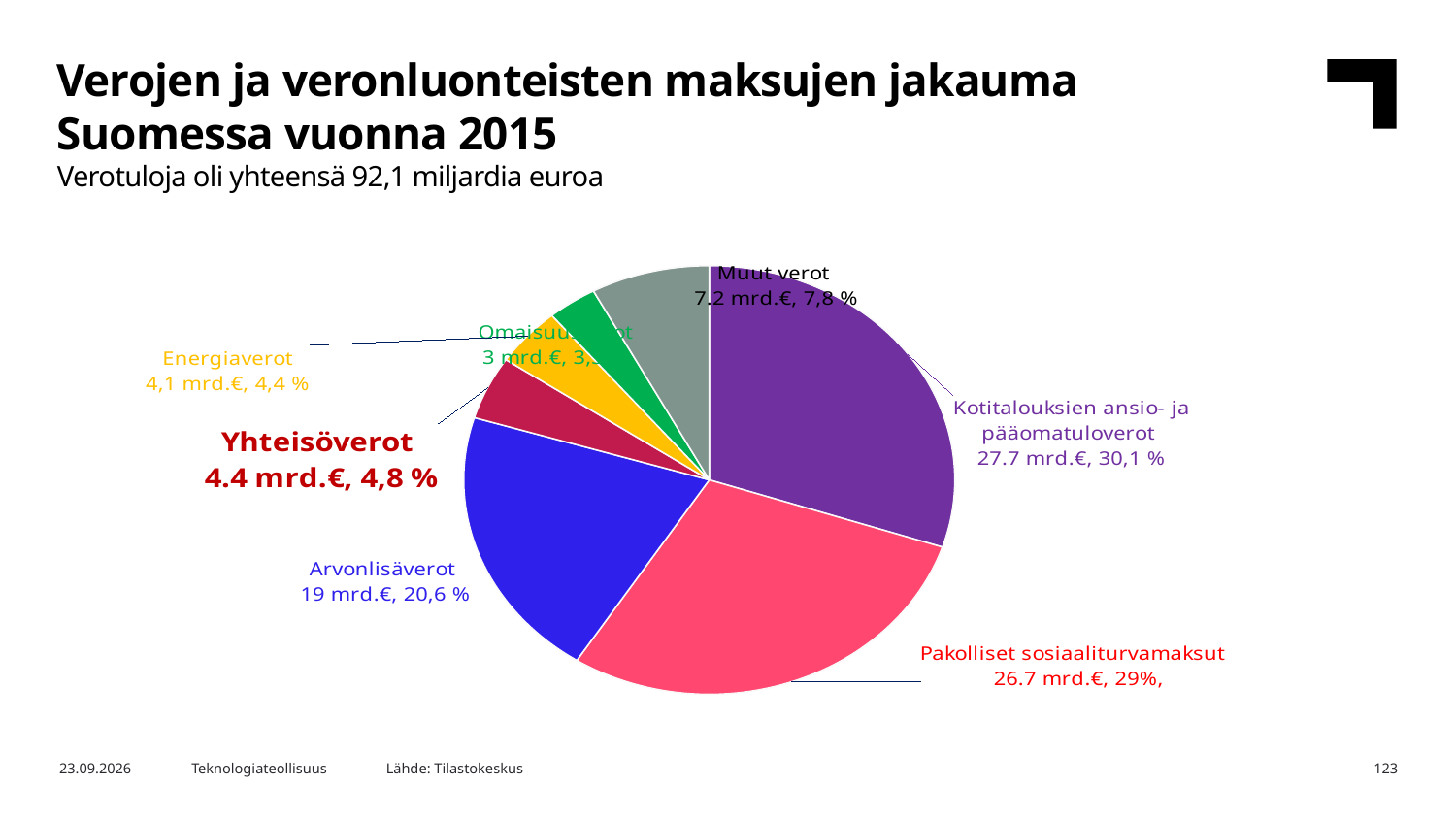
What percentage share is shown for Kotitalouksien ansio- ja pääomatuloverot? 30,1 % How many slices does the pie chart have? 7 Which category has the largest slice of the pie? Kotitalouksien ansio- ja pääomatuloverot Which is larger, Arvonlisäverot or Muut verot? Arvonlisäverot What kind of chart is shown on the slide? pie chart What is the value shown for Yhteisöverot? 4.4 mrd.€ According to the slide subtitle, what was the total tax revenue? 92,1 miljardia euroa What percentage share is shown for Energiaverot? 4,4 % What percentage share is shown for Muut verot? 7,8 % What is the value shown for Arvonlisäverot? 19 mrd.€ What is the difference in mrd.€ between Kotitalouksien ansio- ja pääomatuloverot and Pakolliset sosiaaliturvamaksut? 1 mrd.€ What is the value shown for Pakolliset sosiaaliturvamaksut? 26.7 mrd.€